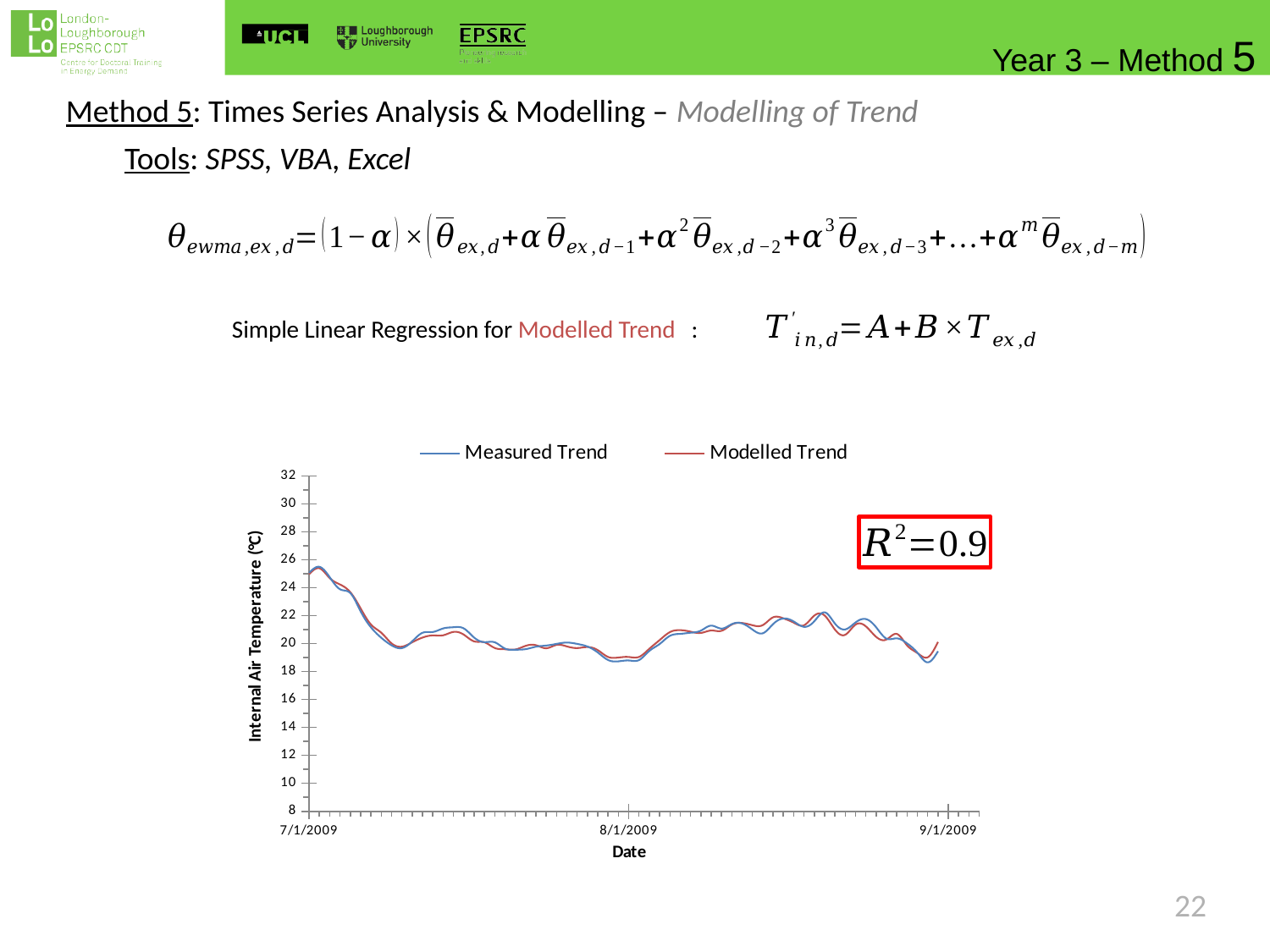
What are the two series named in the chart's legend? Measured Trend and Modelled Trend Do the plotted values rise or fall between 7/1/2009 and mid-July 2009? fall What is the highest value shown on the chart's vertical axis? 32 How many date labels are shown on the chart's x axis? 3 How many series does the chart's legend list? 2 What is the lowest value shown on the chart's vertical axis? 8 Does either series ever rise above 28 on the chart? No Is the Measured Trend value at the start of the chart (7/1/2009) greater or less than 24? greater Is the Measured Trend value around 8/1/2009 greater or less than 20? less What kind of chart is shown on the slide? line chart What R² value is annotated on the chart? 0.9 What is the label of the chart's vertical axis? Internal Air Temperature (°C)